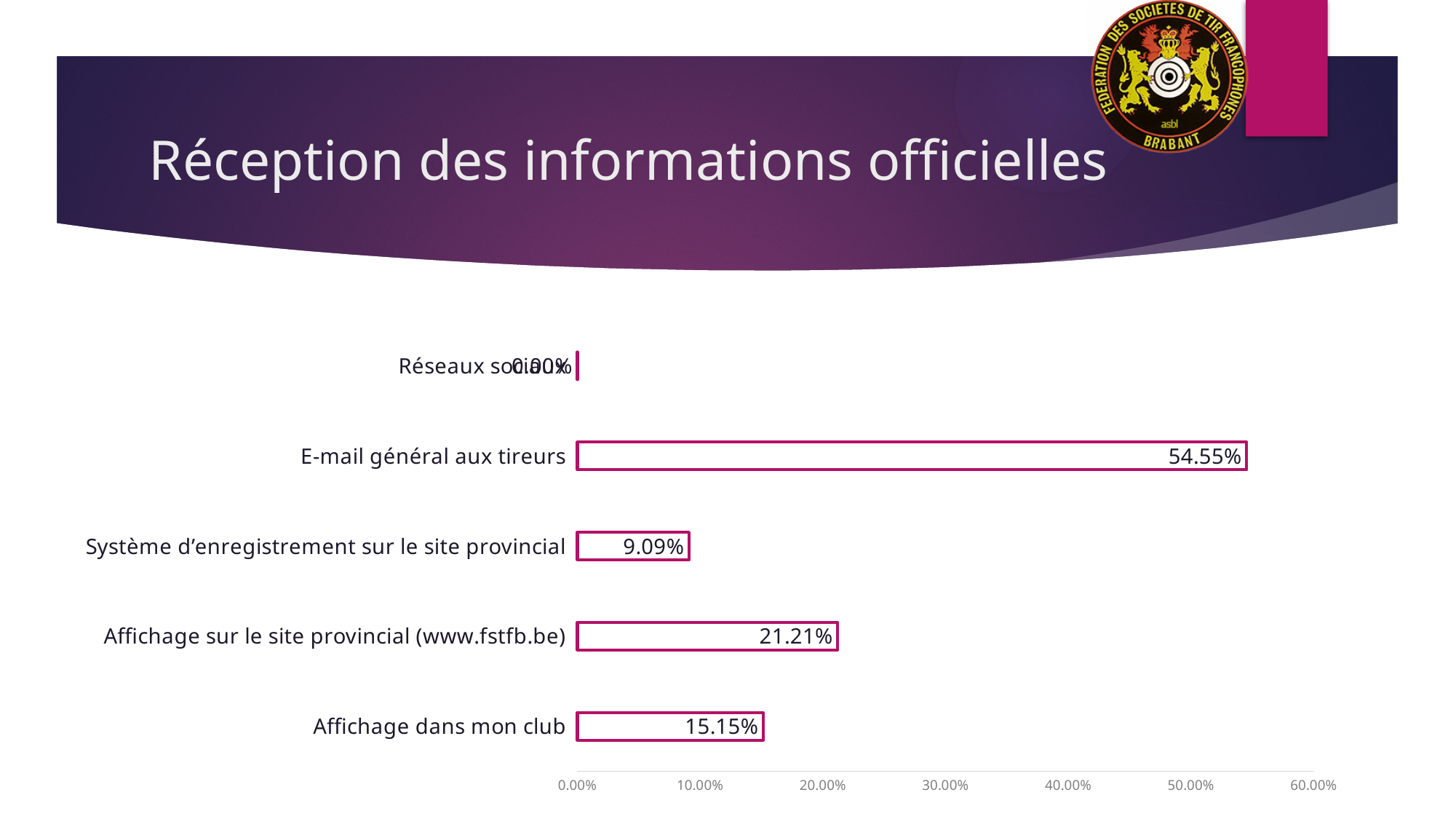
Which is larger, Affichage dans mon club or Système d'enregistrement sur le site provincial? Affichage dans mon club Is the value for E-mail général aux tireurs greater or less than 50.00%? greater What is the difference between Affichage sur le site provincial (www.fstfb.be) and Affichage dans mon club? 6.06% What is the title of the slide? Réception des informations officielles What is the value for Affichage dans mon club? 15.15% Which category has the highest value? E-mail général aux tireurs What is the value for Système d'enregistrement sur le site provincial? 9.09% What is the value for Affichage sur le site provincial (www.fstfb.be)? 21.21% What kind of chart is shown on the slide? bar chart What is the value for E-mail général aux tireurs? 54.55% How many categories are shown in the chart? 5 What is the difference between E-mail général aux tireurs and Affichage sur le site provincial (www.fstfb.be)? 33.34%